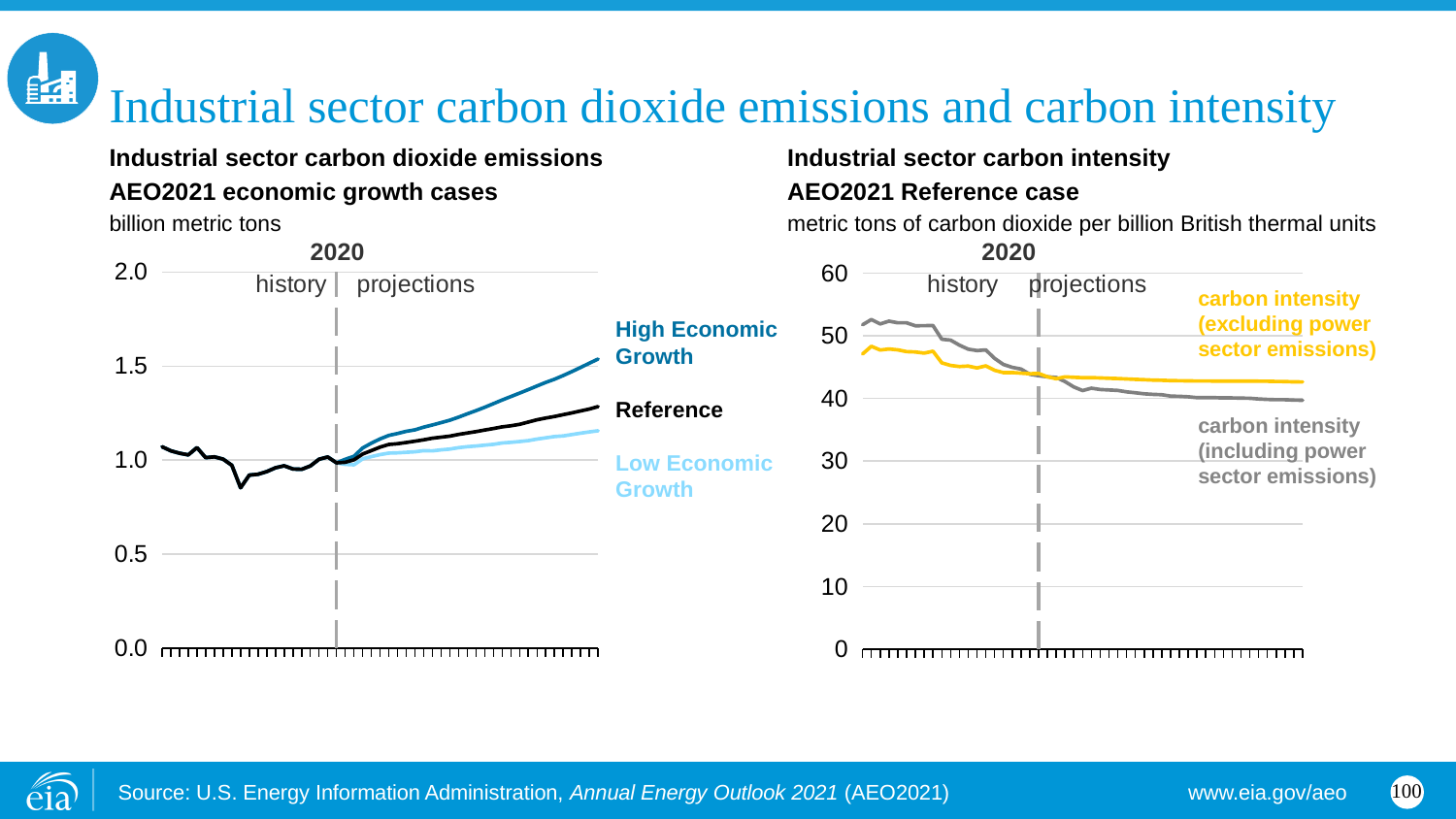
What year does the dashed vertical line separating history from projections mark on both charts? 2020 On the 'Industrial sector carbon intensity' chart, does carbon intensity (including power sector emissions) rise or fall over the period shown? fall On the 'Industrial sector carbon dioxide emissions' chart, is the final projected value for the Reference case greater or less than 1.5? less What kind of chart is the 'Industrial sector carbon intensity' chart on the right? line chart How many series are plotted on the 'Industrial sector carbon intensity' chart? 2 On the 'Industrial sector carbon dioxide emissions' chart, which series ends the projection period higher: High Economic Growth or Low Economic Growth? High Economic Growth How many series are plotted on the 'Industrial sector carbon dioxide emissions' chart? 3 On the 'Industrial sector carbon dioxide emissions' chart, is the final projected value for High Economic Growth greater or less than 1.5? greater What unit is shown on the y axis of the 'Industrial sector carbon dioxide emissions' chart? billion metric tons On the 'Industrial sector carbon intensity' chart, is the final projected value for carbon intensity (excluding power sector emissions) greater or less than 40? greater What kind of chart is the 'Industrial sector carbon dioxide emissions' chart on the left? line chart